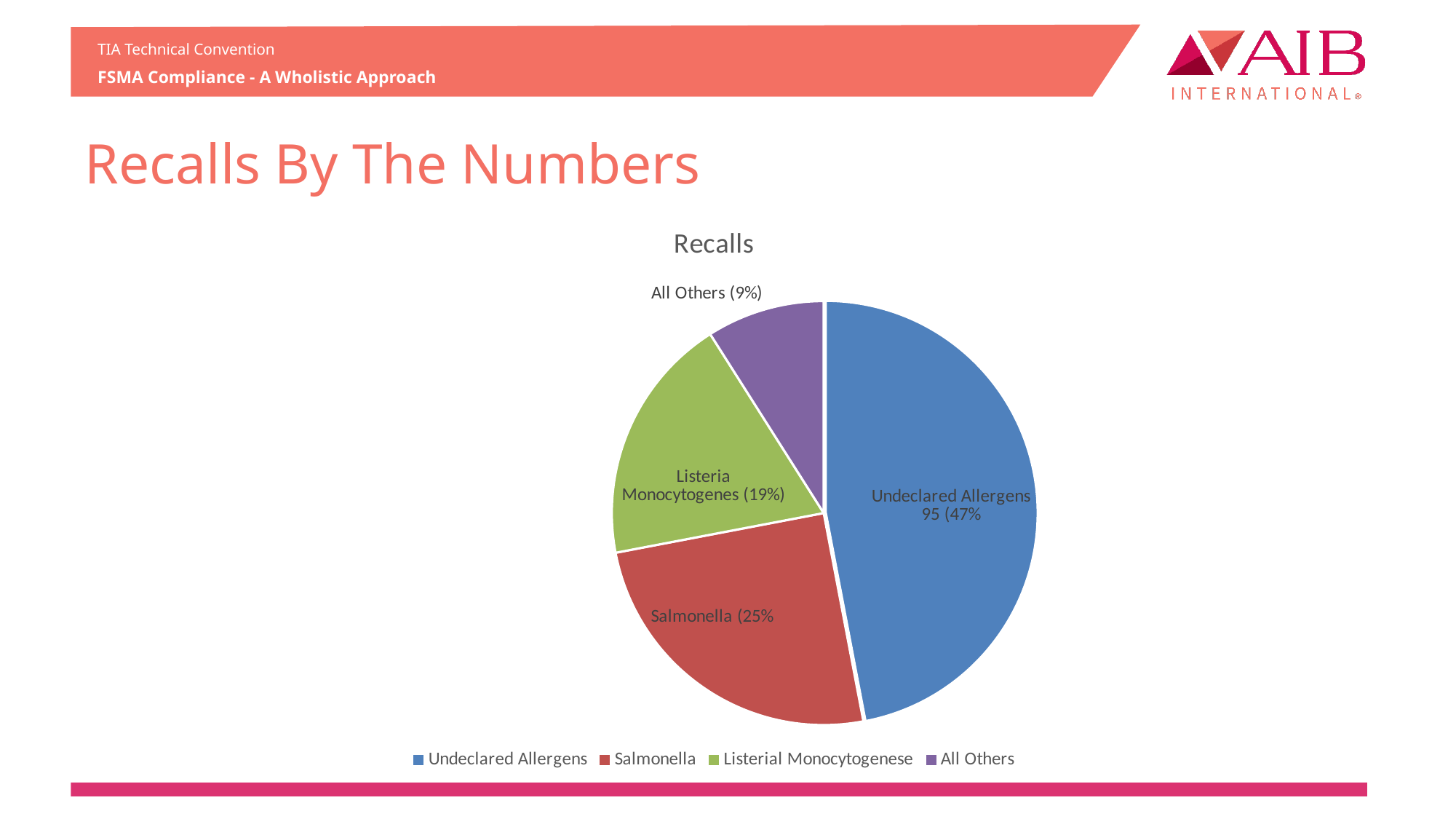
How many categories are shown in the pie chart? 4 What percentage share of recalls is attributed to Salmonella? 25% Which category has the largest share of recalls? Undeclared Allergens What percentage share of recalls is attributed to All Others? 9% What is the difference in percentage points between the Undeclared Allergens share and the Salmonella share? 22 percentage points Which has a larger share of recalls, Salmonella or Listeria Monocytogenes? Salmonella Which category has the smallest share of recalls? All Others What percentage share of recalls is attributed to Undeclared Allergens? 47% What type of chart is shown on the slide? Pie chart What is the title of the chart? Recalls What colour is the Undeclared Allergens slice? Blue